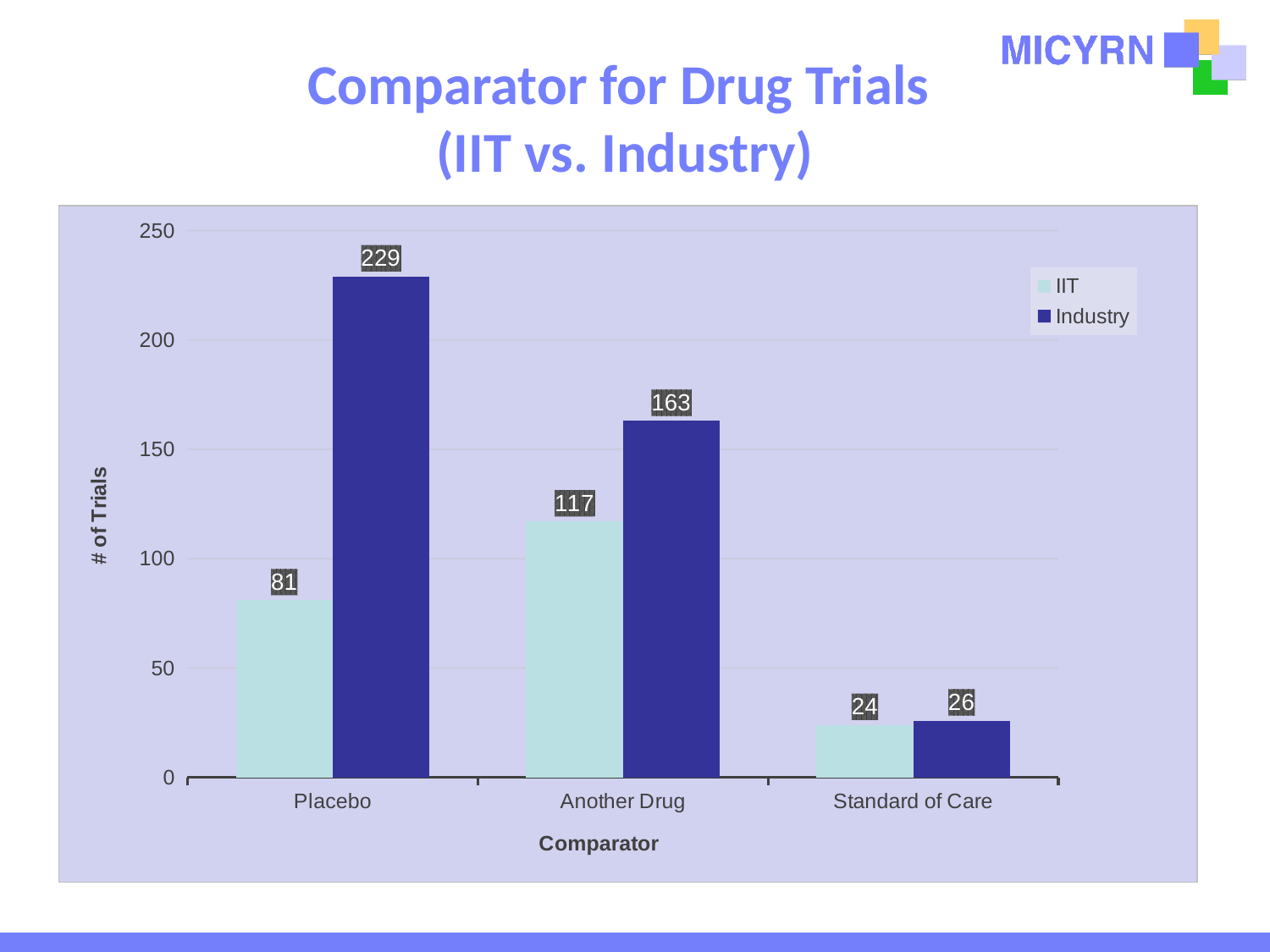
For Placebo, which series has the larger value, IIT or Industry? Industry What is the label of the y axis? # of Trials Which comparator has the highest number of Industry trials? Placebo What is the difference between the Industry and IIT values for Placebo? 148 What is the value for Standard of Care in the IIT series? 24 Which comparator has the lowest number of IIT trials? Standard of Care What is the difference between the Industry and IIT values for Another Drug? 46 How many comparator categories are shown on the x axis? 3 How many trials used Placebo as the comparator in the Industry series? 229 How many series does the legend list? 2 What kind of chart is shown on the slide? Bar chart What is the number of IIT trials with Another Drug as the comparator? 117